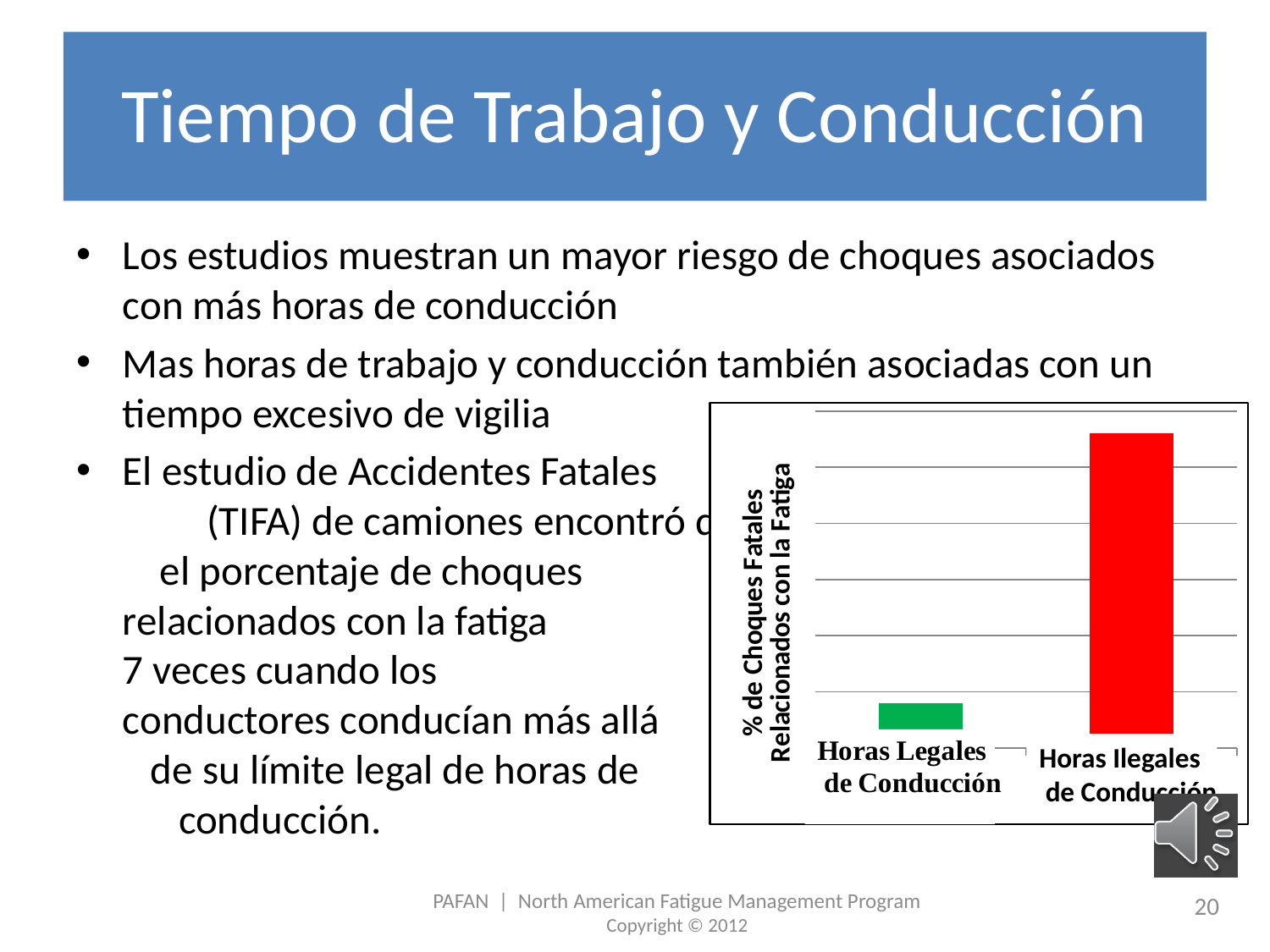
What colour is the bar for Horas Ilegales de Conducción? red What kind of chart is shown on the slide? bar chart What is the label on the vertical axis of the chart? % de Choques Fatales Relacionados con la Fatiga Which is larger, the bar for Horas Legales de Conducción or the bar for Horas Ilegales de Conducción? Horas Ilegales de Conducción How many bars does the chart show? 2 Which category has the lowest value in the chart? Horas Legales de Conducción Which category has the highest value in the chart? Horas Ilegales de Conducción